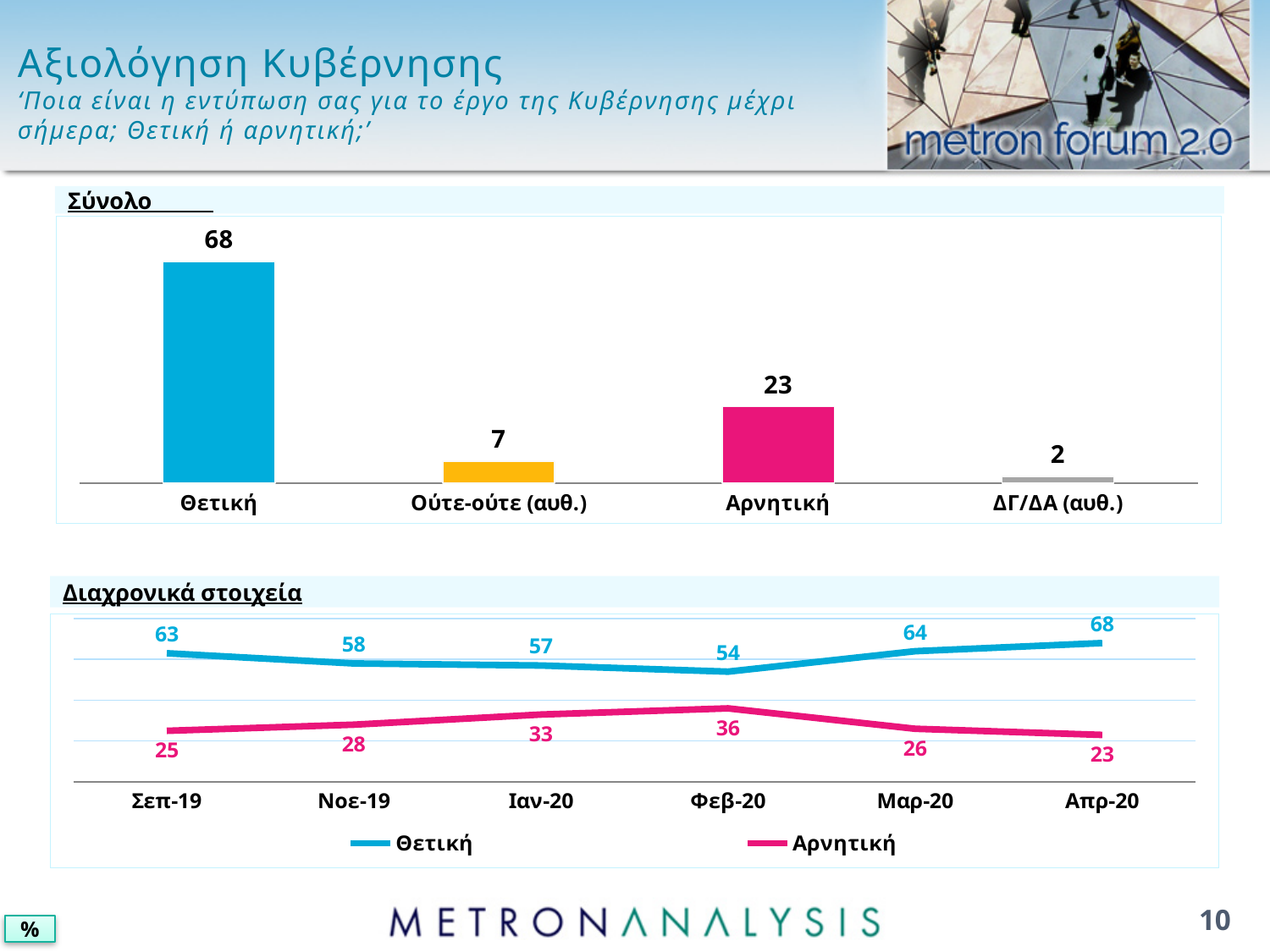
In the 'Διαχρονικά στοιχεία' chart, what is the value of Θετική for Φεβ-20? 54 In the 'Διαχρονικά στοιχεία' chart, does Θετική rise or fall from Φεβ-20 to Απρ-20? Rise What kind of chart is the 'Σύνολο' chart? Bar chart In the 'Σύνολο' chart, what is the value for Αρνητική? 23 In the 'Διαχρονικά στοιχεία' chart, what is the value of Αρνητική for Ιαν-20? 33 In the 'Σύνολο' chart, which category has the lowest value? ΔΓ/ΔΑ (αυθ.) In the 'Διαχρονικά στοιχεία' chart, in which month does Αρνητική reach its highest value? Φεβ-20 In the 'Σύνολο' chart, how many categories are shown? 4 In the 'Σύνολο' chart, what is the value for Θετική? 68 In the 'Σύνολο' chart, what is the difference between Θετική and Αρνητική? 45 In the 'Διαχρονικά στοιχεία' chart, which is larger for Σεπ-19: Θετική or Αρνητική? Θετική In the 'Διαχρονικά στοιχεία' chart, how many series does the legend list? 2